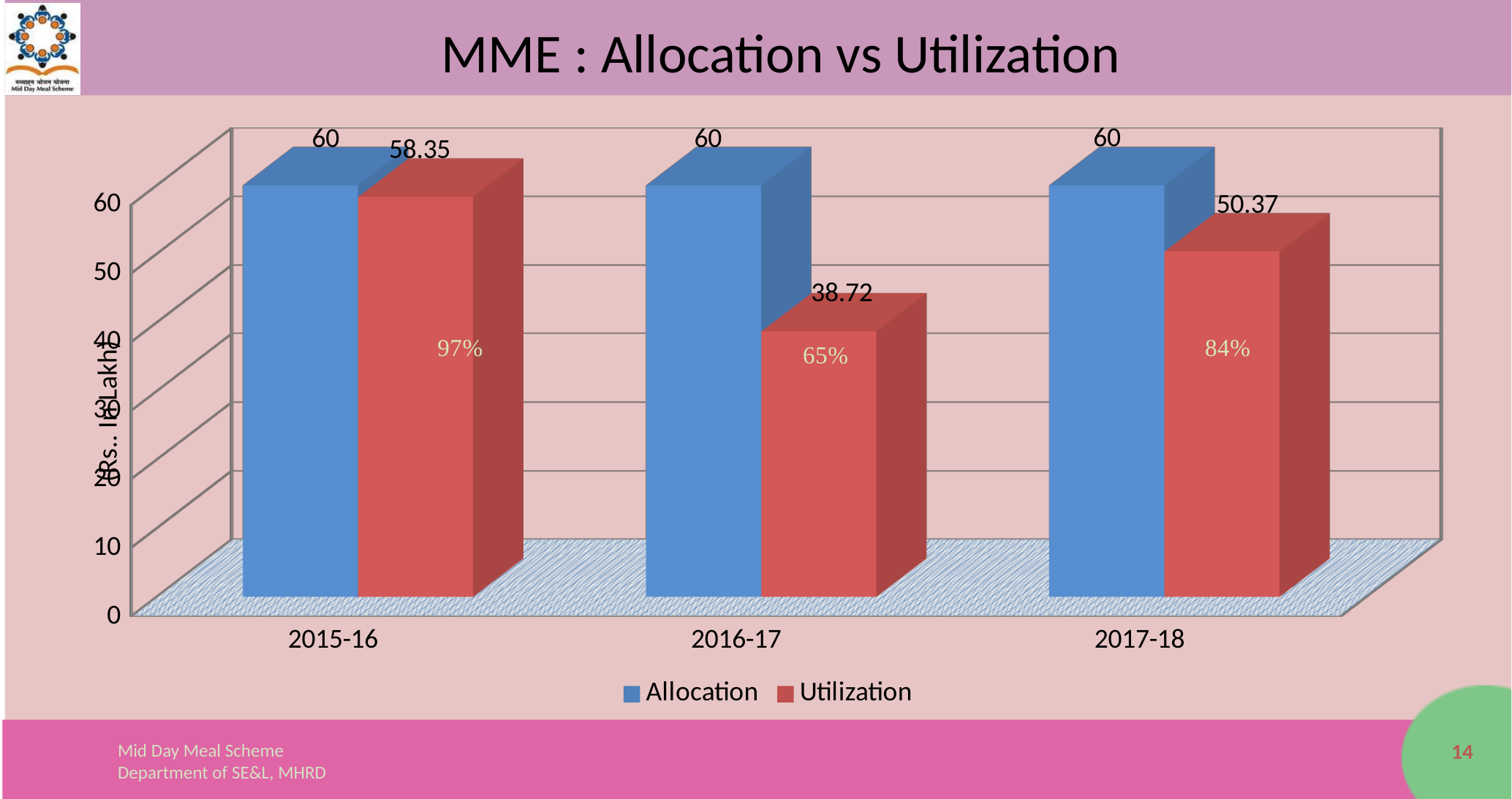
How many series does the legend list? 2 What is the difference between Allocation and Utilization in 2016-17? 21.28 How many years are shown on the x axis? 3 Which is larger, the Utilization for 2015-16 or for 2017-18? 2015-16 What percentage label is shown on the Utilization bar for 2017-18? 84% Which year has the highest Utilization? 2015-16 What is the Utilization value for 2016-17? 38.72 What is the Utilization value for 2017-18? 50.37 What is the title of the chart? MME : Allocation vs Utilization What is the Allocation value for 2015-16? 60 What kind of chart is shown on the slide? Bar chart Which year has the lowest Utilization? 2016-17